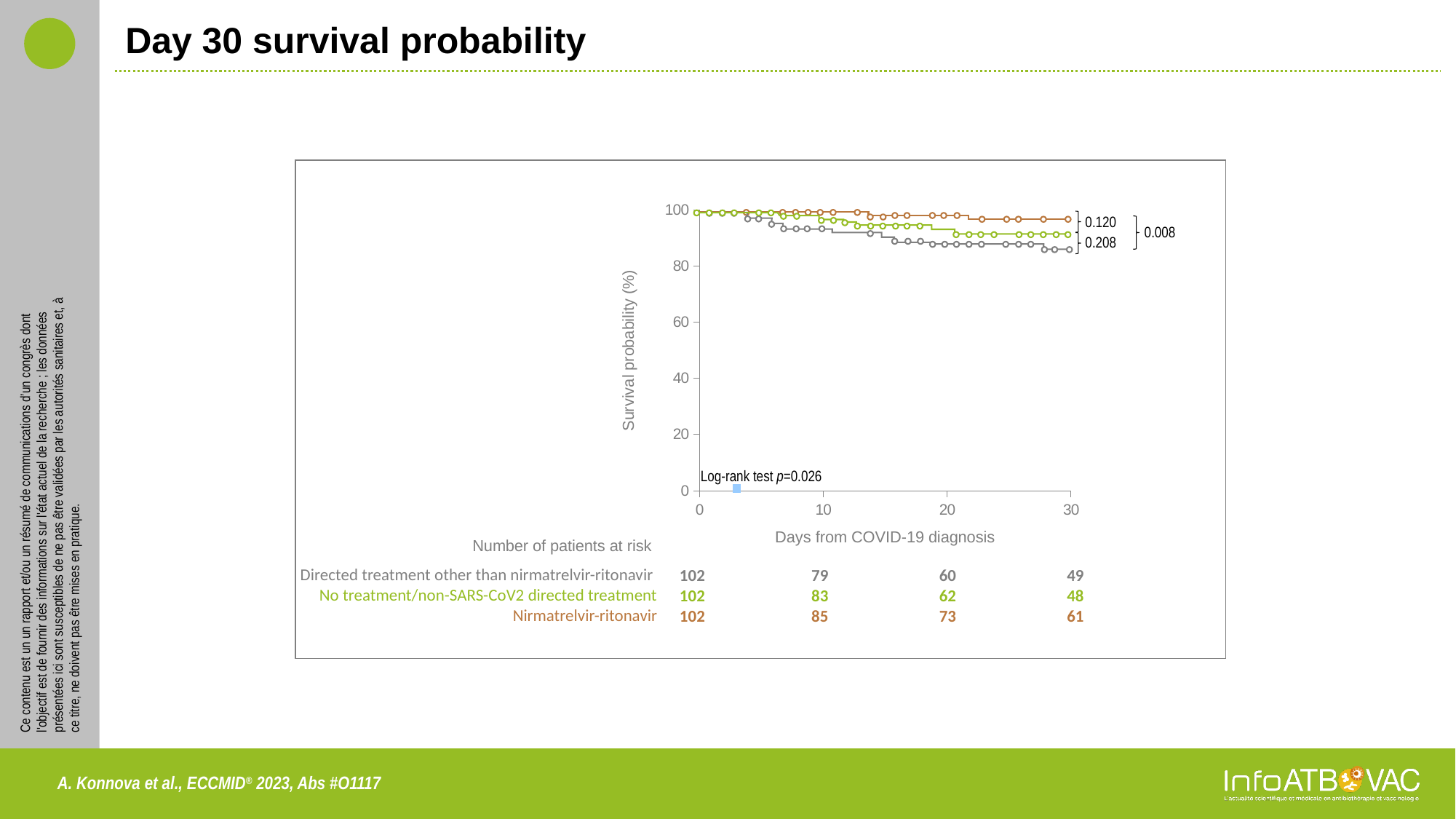
What is the difference in the number of patients at risk at day 20 between the Nirmatrelvir-ritonavir group and the Directed treatment other than nirmatrelvir-ritonavir group? 13 What is the label of the y axis of the chart? Survival probability (%) How many patients in the No treatment/non-SARS-CoV2 directed treatment group were at risk at day 10? 83 What kind of chart is shown on the slide? Line chart (Kaplan-Meier survival curve) Do the survival probability curves rise or fall as days from COVID-19 diagnosis increase? fall Which treatment group has the lowest survival probability at day 30? Directed treatment other than nirmatrelvir-ritonavir Which treatment group has the highest survival probability at day 30? Nirmatrelvir-ritonavir How many patients in the Nirmatrelvir-ritonavir group were at risk at day 30? 61 Is the survival probability for the Nirmatrelvir-ritonavir group at day 30 greater or less than 80? greater What is the label of the x axis of the chart? Days from COVID-19 diagnosis What is the log-rank test p-value shown on the chart? p=0.026 How many treatment groups (series) are plotted on the survival chart? 3